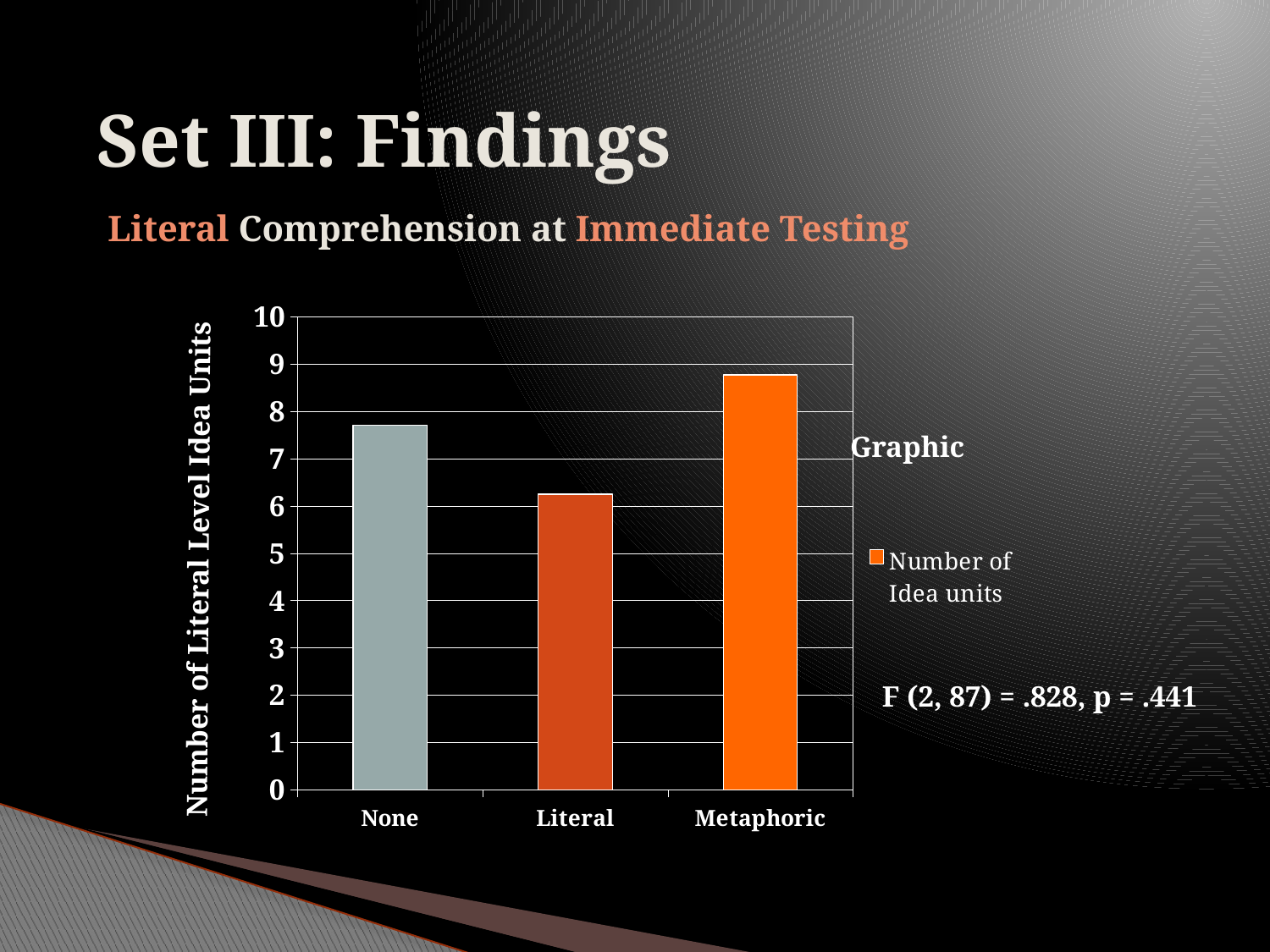
Is the value for Metaphoric greater or less than 8? greater Which is larger, the value for None or the value for Literal? None Which category has the lowest number of literal level idea units? Literal Which category has the highest number of literal level idea units? Metaphoric Is the value for Literal greater or less than 7? less How many categories are shown on the x axis of the chart? 3 Is the value for None greater or less than 7? greater How many series does the chart's legend list? 1 Which is larger, the value for Metaphoric or the value for None? Metaphoric What kind of chart is shown on the slide? bar chart What is the label on the chart's vertical axis? Number of Literal Level Idea Units What series name is listed in the chart's legend? Number of Idea units